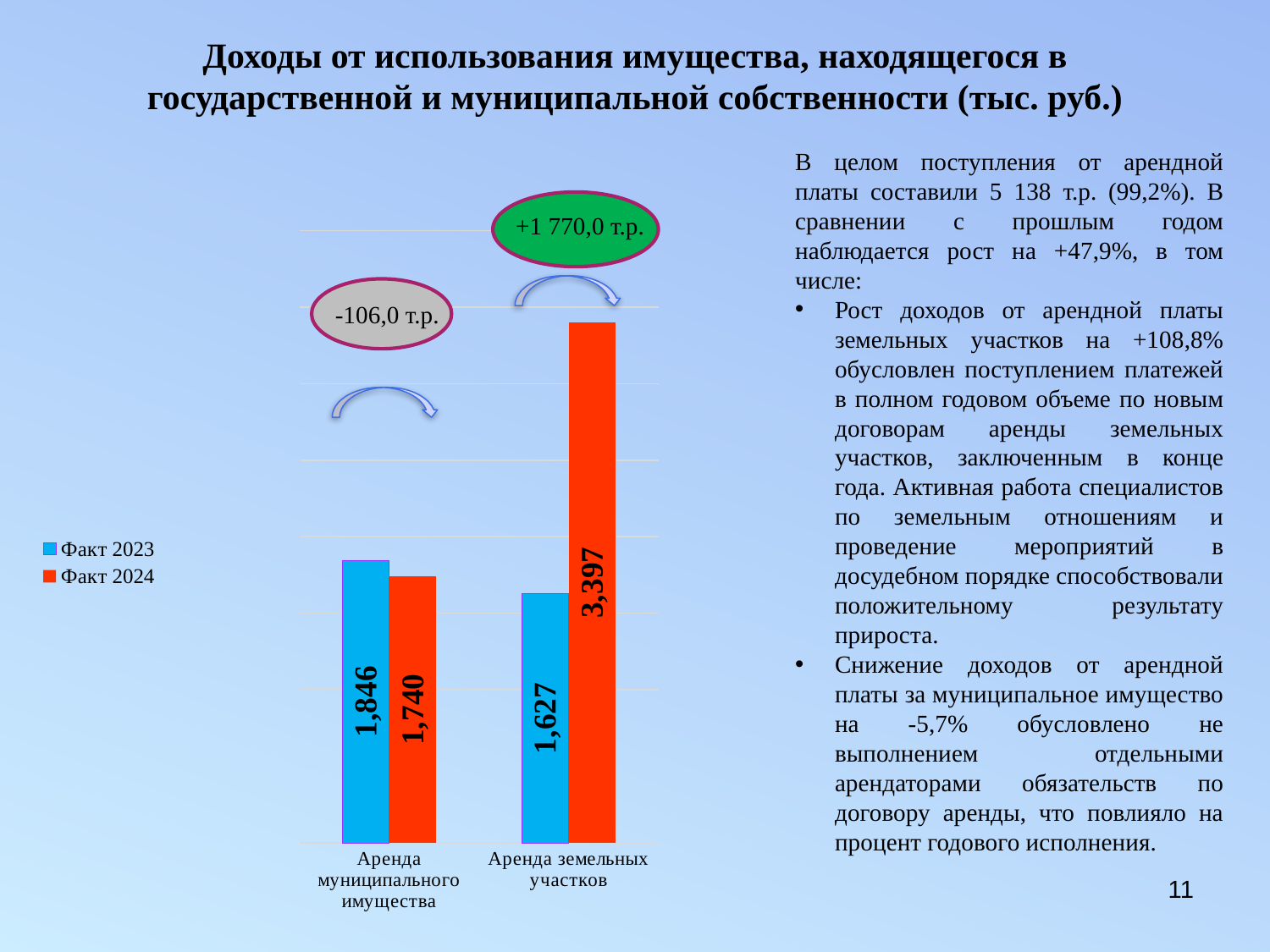
Which bar has the lowest value on the chart? Факт 2023, Аренда земельных участков What kind of chart is shown on the slide? Bar chart What is the Факт 2023 value for Аренда муниципального имущества? 1,846 What is the Факт 2024 value for Аренда муниципального имущества? 1,740 How many categories are shown on the x axis? 2 Which bar has the highest value on the chart? Факт 2024, Аренда земельных участков For Аренда муниципального имущества, which is larger: Факт 2023 or Факт 2024? Факт 2023 What is the Факт 2024 value for Аренда земельных участков? 3,397 What is the difference between the Факт 2024 and Факт 2023 values for Аренда земельных участков? 1,770 What is the Факт 2023 value for Аренда земельных участков? 1,627 What is the difference between the Факт 2023 and Факт 2024 values for Аренда муниципального имущества? 106 How many series does the legend list? 2